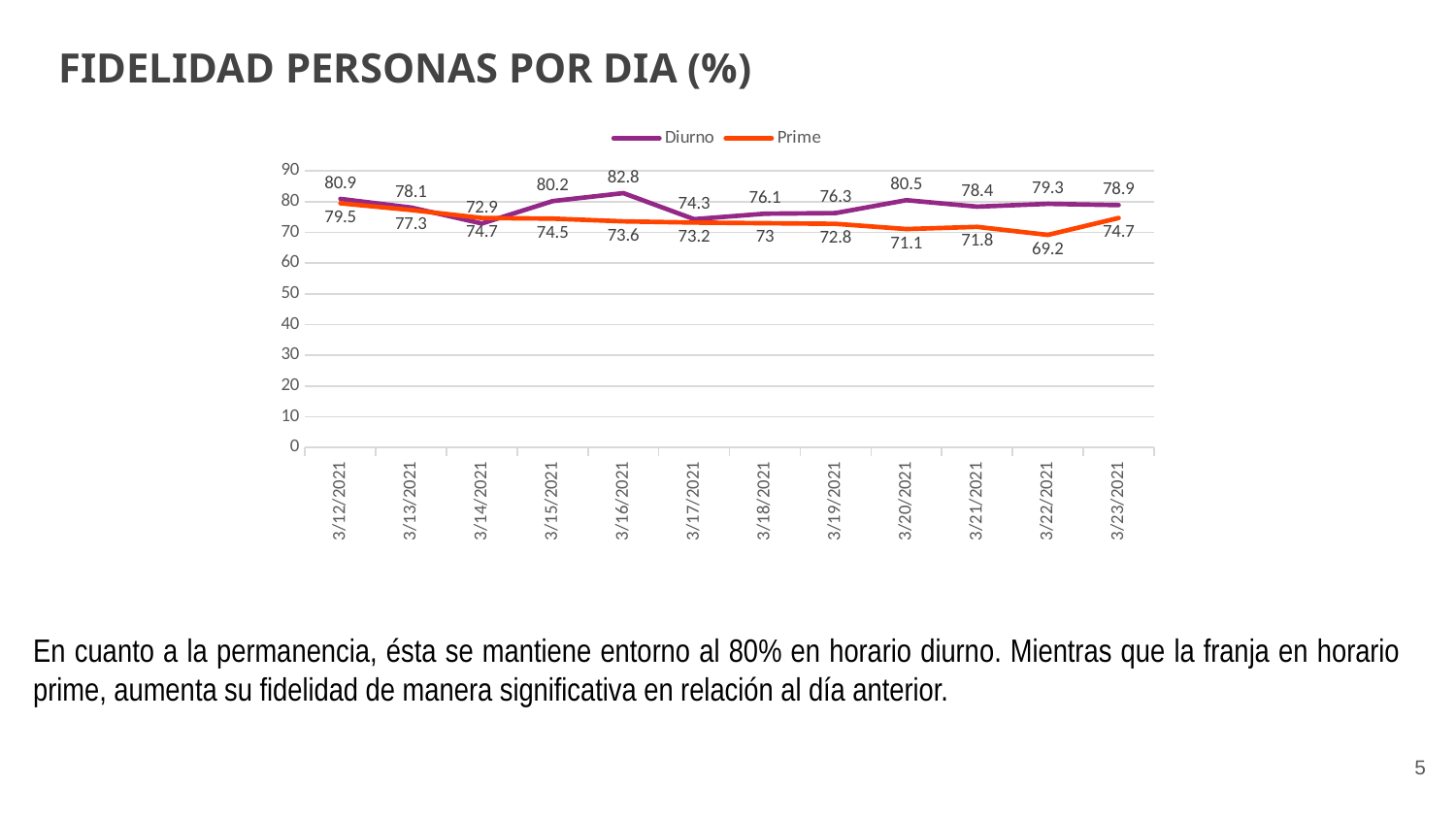
On 3/14/2021, which series has the larger value, Diurno or Prime? Prime How many series does the legend list? 2 Is the Prime value on 3/20/2021 greater or less than 80? less On which date is the Diurno series lowest? 3/14/2021 On which date is the Prime series lowest? 3/22/2021 What is the Prime value on 3/12/2021? 79.5 What is the Prime value on 3/22/2021? 69.2 What is the difference between the Diurno and Prime values on 3/22/2021? 10.1 What kind of chart is shown on the slide? line chart What is the Diurno value on 3/16/2021? 82.8 On which date is the Diurno series highest? 3/16/2021 How many dates are plotted on the x axis? 12